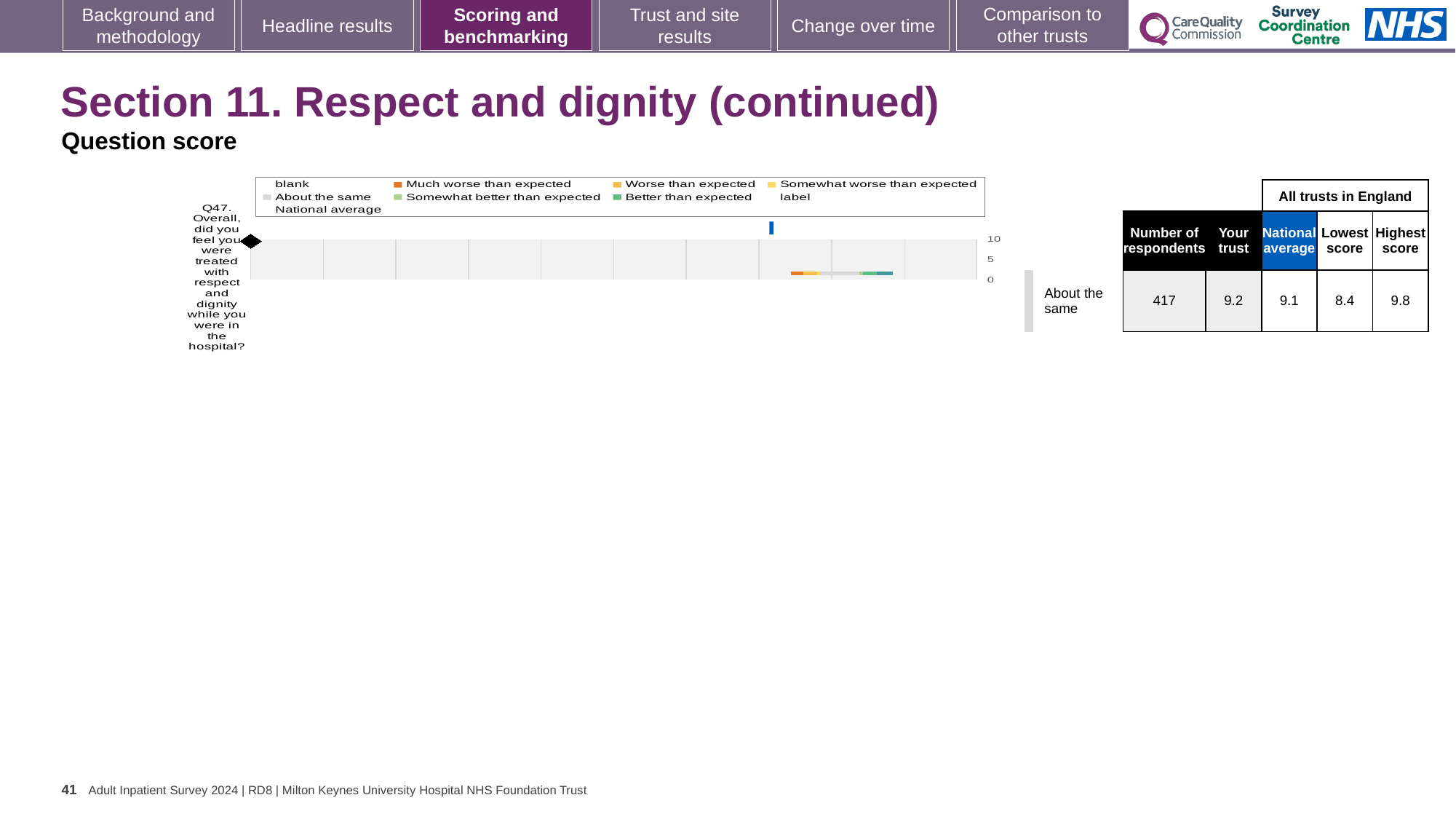
What kind of chart is shown on the slide? bar chart What is the lowest score among all trusts in England for Q47? 8.4 What is the difference between the highest score and the lowest score for Q47? 1.4 How many questions are plotted in the chart? 1 What is the 'Your trust' score for Q47? 9.2 Which question number is plotted in the chart? Q47 What is the highest score among all trusts in England for Q47? 9.8 Which is larger for Q47, the 'Your trust' score or the national average? Your trust How many respondents answered Q47? 417 What is the national average score for Q47? 9.1 Is the 'Your trust' score for Q47 greater or less than 5? greater Which benchmark category is the trust's Q47 score placed in? About the same